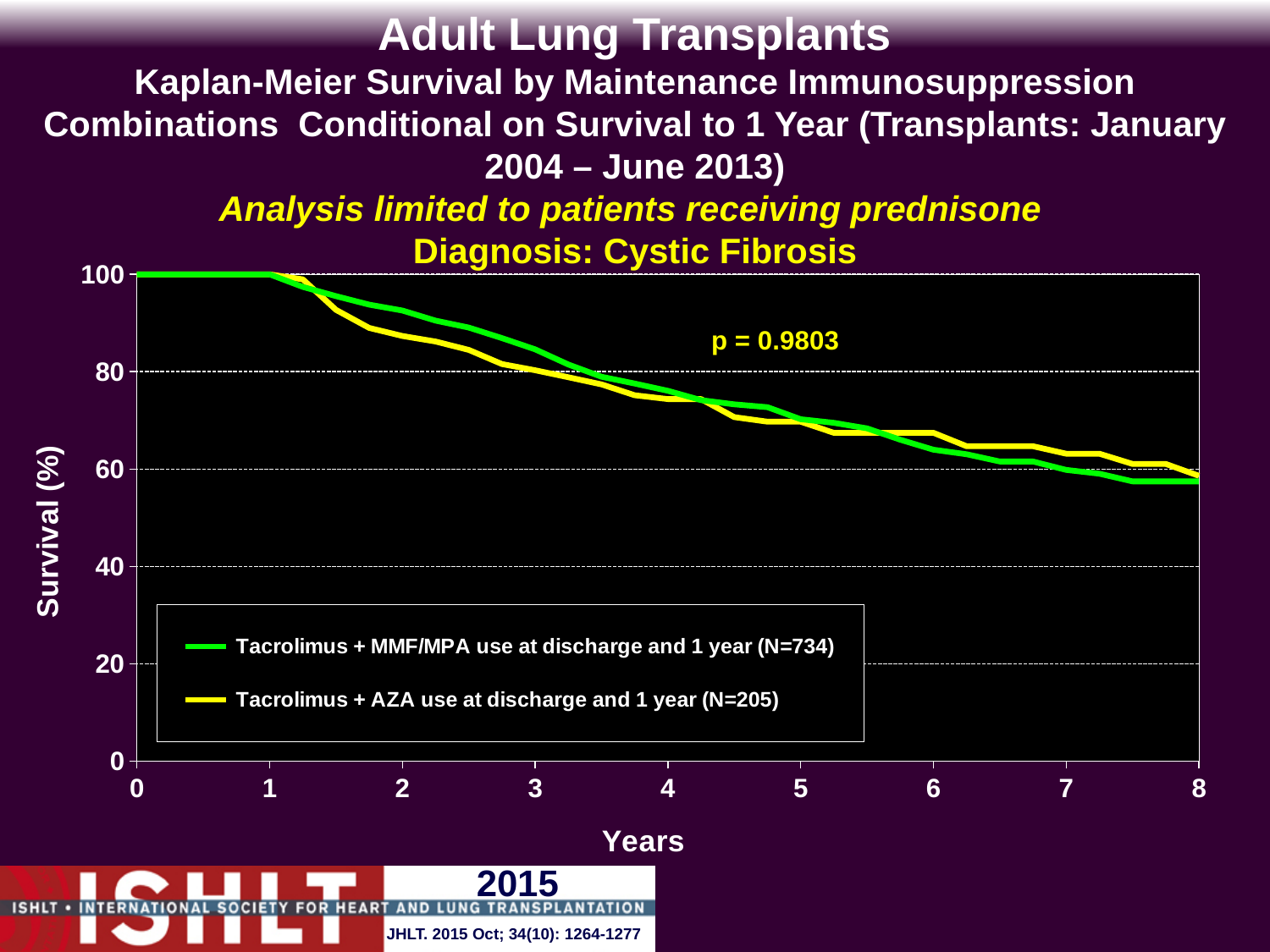
What p-value is printed on the chart? p = 0.9803 What is the N for the Tacrolimus + MMF/MPA use at discharge and 1 year group? N=734 Is the survival value for the Tacrolimus + AZA group at year 4 greater or less than 80? less What colour is the line for the Tacrolimus + AZA use at discharge and 1 year group? yellow What is the N for the Tacrolimus + AZA use at discharge and 1 year group? N=205 How many series does the legend list? 2 Do the survival curves rise or fall as years increase? fall What is the label of the y-axis? Survival (%) What kind of chart is shown on the slide? line chart At year 2, which group has the higher survival: Tacrolimus + MMF/MPA or Tacrolimus + AZA? Tacrolimus + MMF/MPA Is the survival value for the Tacrolimus + MMF/MPA group at year 2 greater or less than 80? greater Is the survival value for the Tacrolimus + MMF/MPA group at year 6 greater or less than 80? less